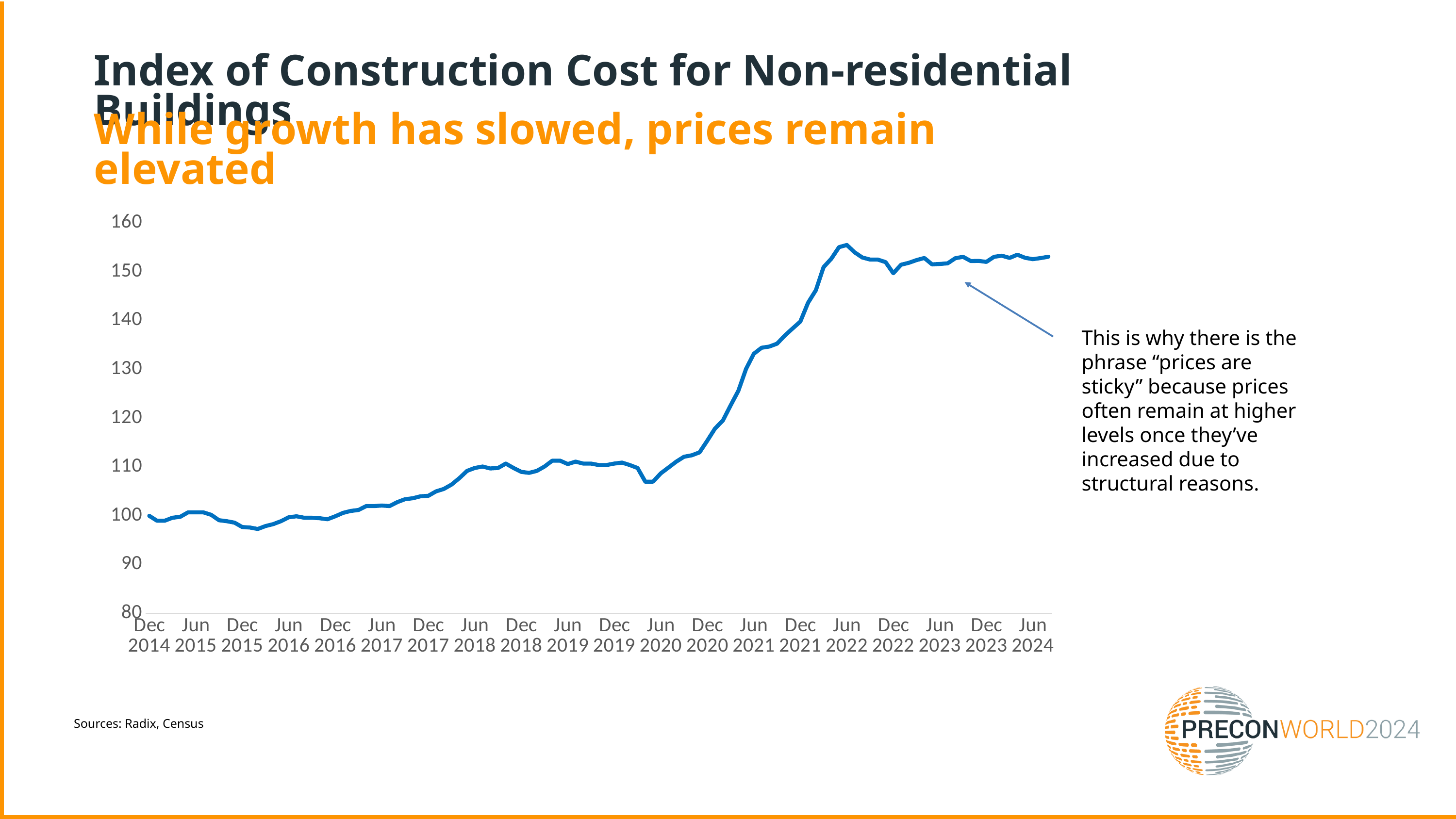
Which is larger, the index value at Dec 2014 or at Jun 2022? Jun 2022 Overall, does the index rise or fall from Dec 2014 to Jun 2024? rise Is the value of the index at Jun 2021 greater or less than 130? greater Is the value of the index at Jun 2022 greater or less than 150? greater Which is larger, the index value at Jun 2021 or at Jun 2020? Jun 2021 What kind of chart is shown on the slide? line chart What sources are cited for the chart? Radix, Census Is the value of the index at Jun 2024 greater or less than 150? greater What is the title of the chart on the slide? Index of Construction Cost for Non-residential Buildings How many date labels are shown along the x axis? 20